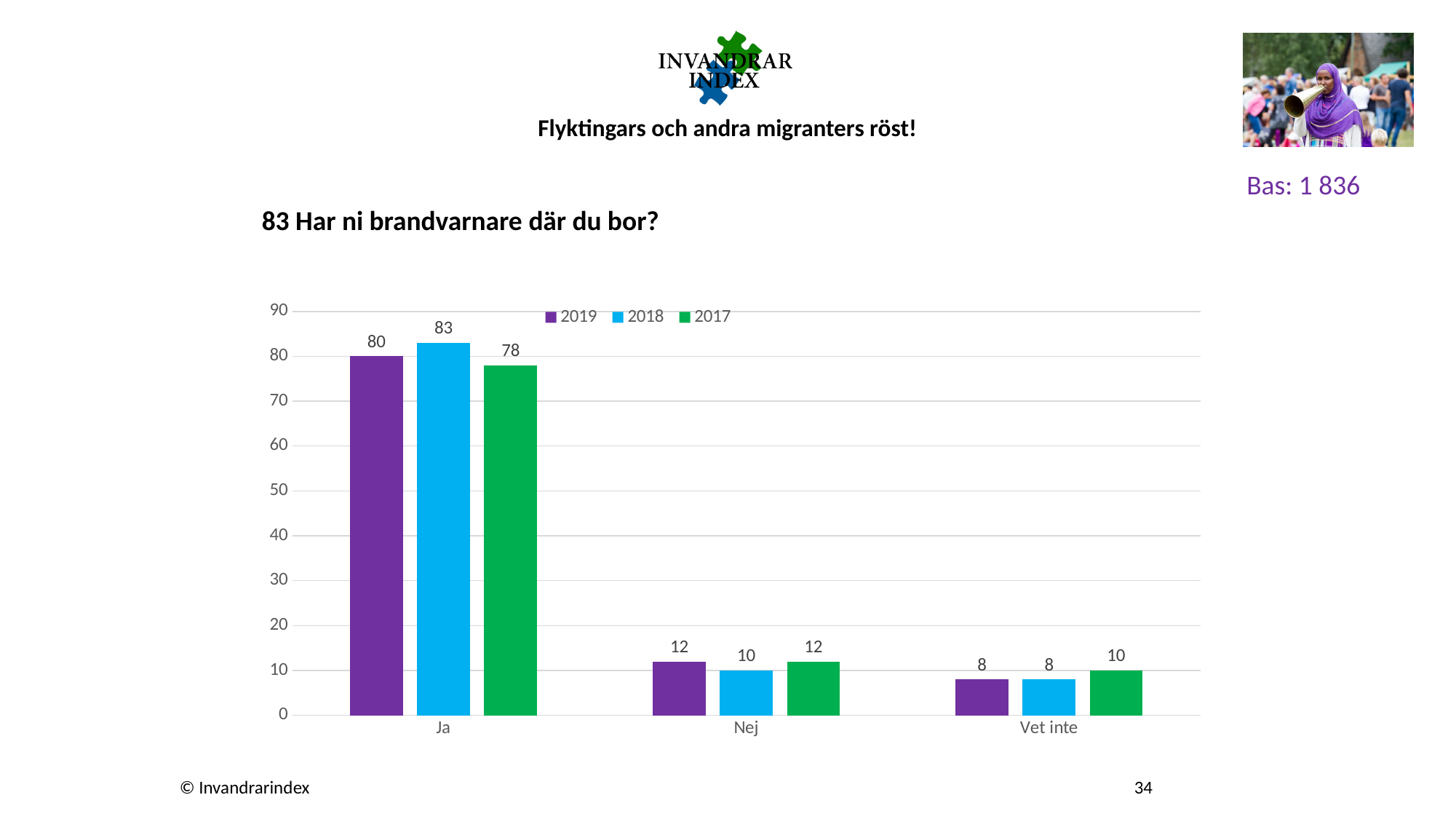
What is the value for Nej in the 2017 series? 12 What is the value for Vet inte in the 2018 series? 8 Which series is shown in green in the legend? 2017 What is the value for Ja in the 2018 series? 83 Which category has the lowest value in the 2019 series? Vet inte How many categories are shown on the x axis? 3 What is the value for Ja in the 2019 series? 80 Which is larger for Nej: the 2019 value or the 2018 value? 2019 What is the difference between the 2018 and 2017 values for Ja? 5 Which category has the highest value in the 2017 series? Ja What kind of chart is shown on the slide? Bar chart How many series does the legend list? 3